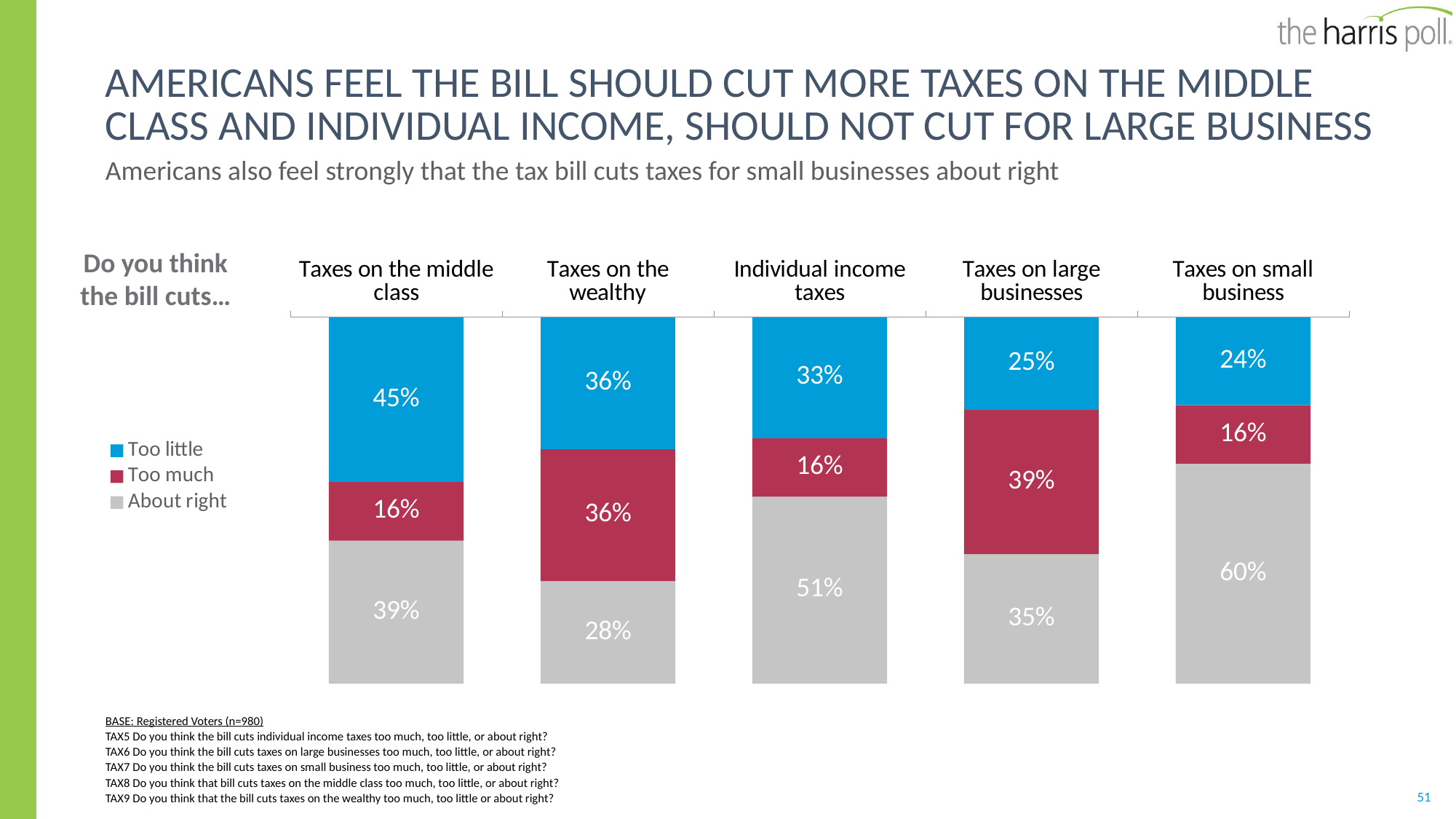
What percentage say the bill cuts individual income taxes about right? 51% Which category has the lowest 'About right' percentage? Taxes on the wealthy What percentage say the bill cuts taxes on the wealthy too much? 36% Which is larger: the 'Too little' percentage for taxes on the wealthy or for taxes on small business? Taxes on the wealthy What is the difference between the 'Too much' percentages for taxes on large businesses and taxes on the middle class? 23% What percentage say the bill cuts taxes on large businesses too much? 39% What percentage say the bill cuts taxes on small business about right? 60% How many categories are shown in the chart? 5 Which category has the highest 'Too little' percentage? Taxes on the middle class How many series does the legend list? 3 What kind of chart is shown on the slide? Stacked bar chart What percentage say the bill cuts taxes on the middle class too little? 45%